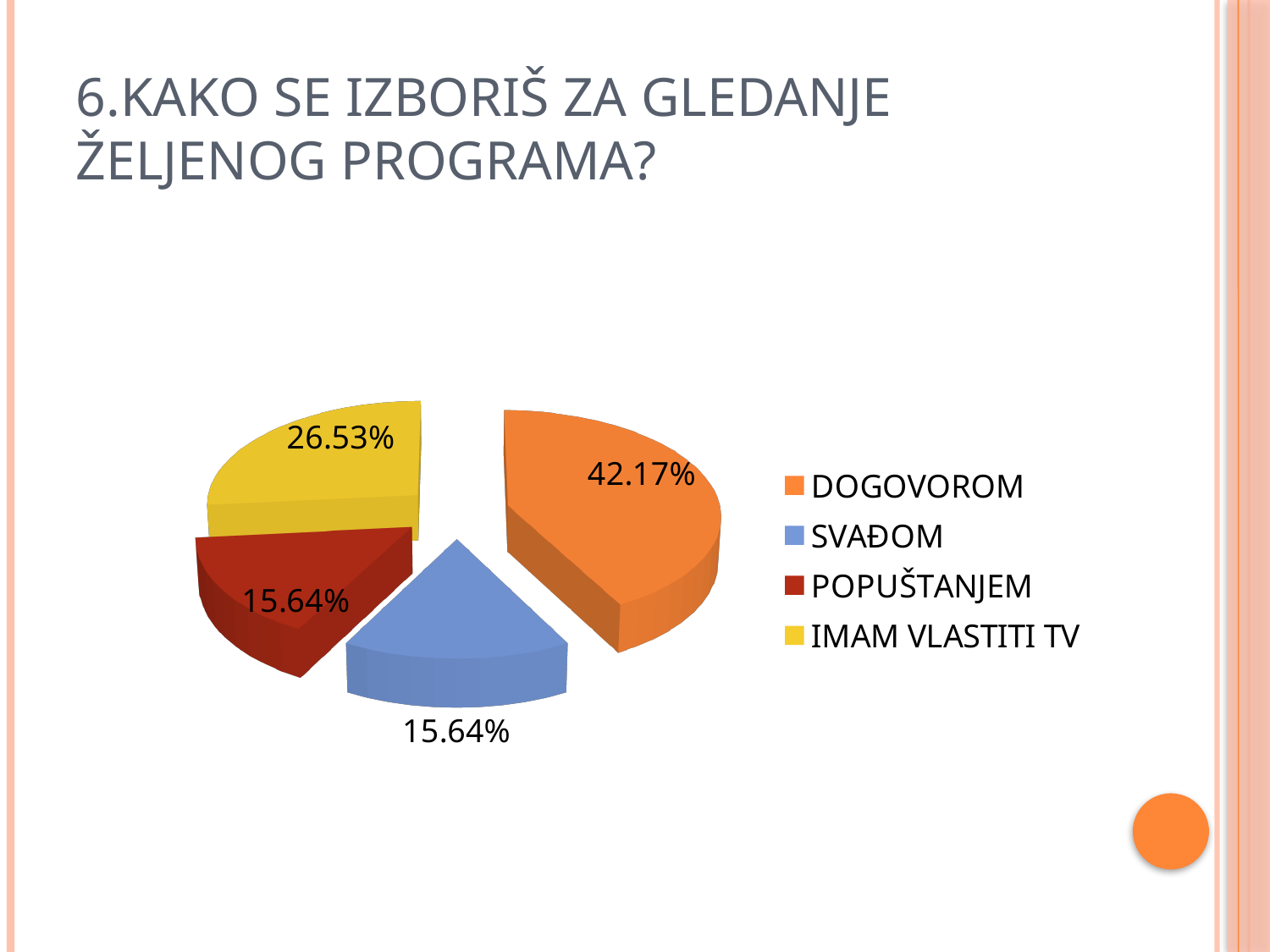
What percentage is shown for IMAM VLASTITI TV? 26.53% What is the difference between the shares for IMAM VLASTITI TV and POPUŠTANJEM? 10.89% What kind of chart is shown on the slide? pie chart Which is larger, the share for IMAM VLASTITI TV or the share for SVAĐOM? IMAM VLASTITI TV What is the title of the slide containing the chart? 6.KAKO SE IZBORIŠ ZA GLEDANJE ŽELJENOG PROGRAMA? What colour is the slice for SVAĐOM? blue What percentage is shown for SVAĐOM? 15.64% What percentage is shown for DOGOVOROM? 42.17% Which category has the largest share of the pie? DOGOVOROM How many categories does the legend list? 4 What percentage is shown for POPUŠTANJEM? 15.64% What is the difference between the shares for DOGOVOROM and IMAM VLASTITI TV? 15.64%